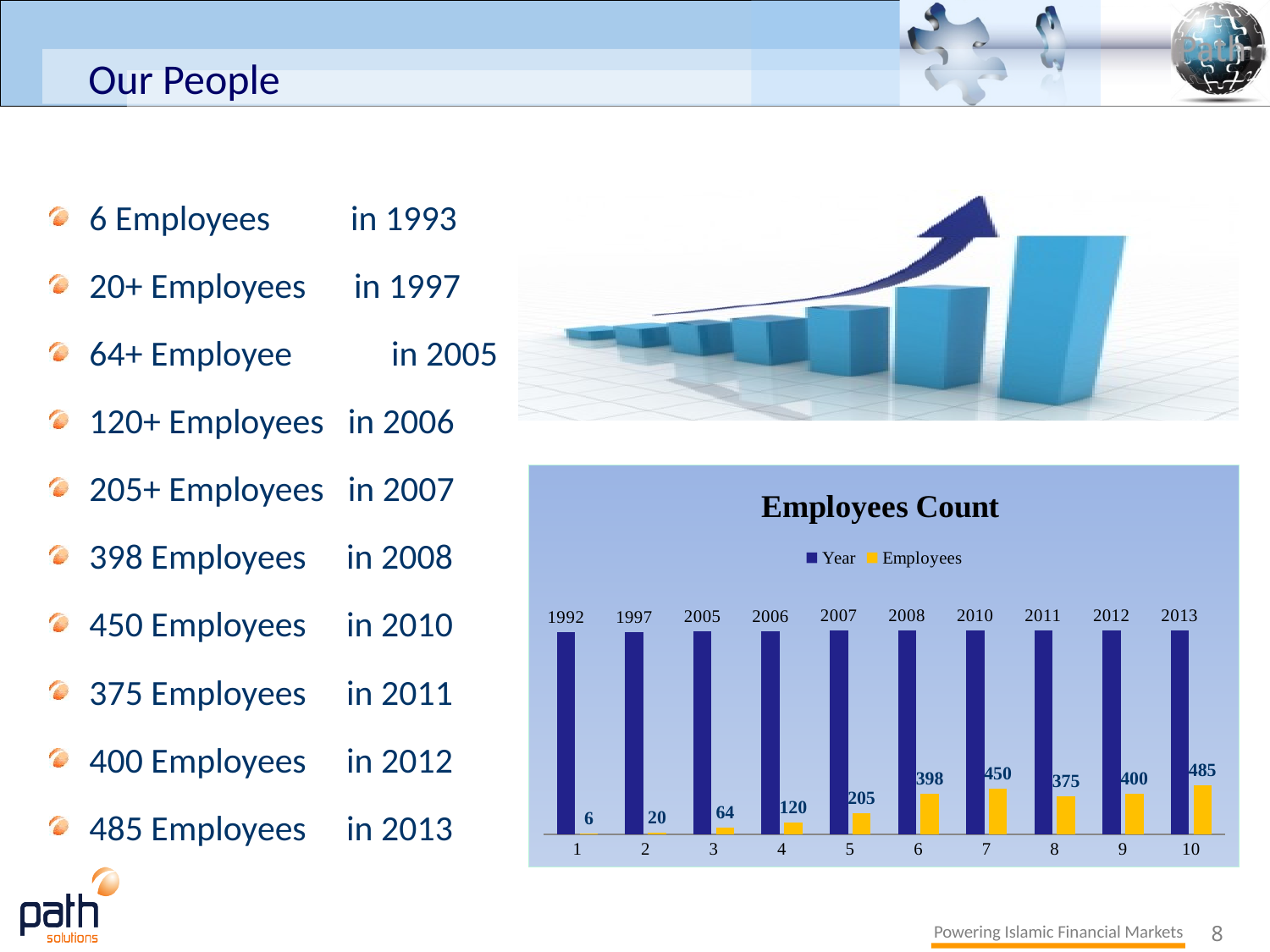
Which colour represents the Employees series in the chart? yellow What is the Employees value labelled for the bar under the year 2013? 485 What is the Employees value labelled for the bar under the year 2008? 398 What is the difference between the Employees values for 2013 and 2012? 85 What is the Employees value labelled for the bar under the year 2005? 64 Which is larger, the Employees value for 2010 or for 2011? 2010 Which year has the lowest Employees value in the chart? 1992 What is the title of the chart? Employees Count What type of chart is shown on the slide? bar chart How many series does the chart legend list? 2 Which year has the highest Employees value in the chart? 2013 How many categories are shown along the x axis of the chart? 10